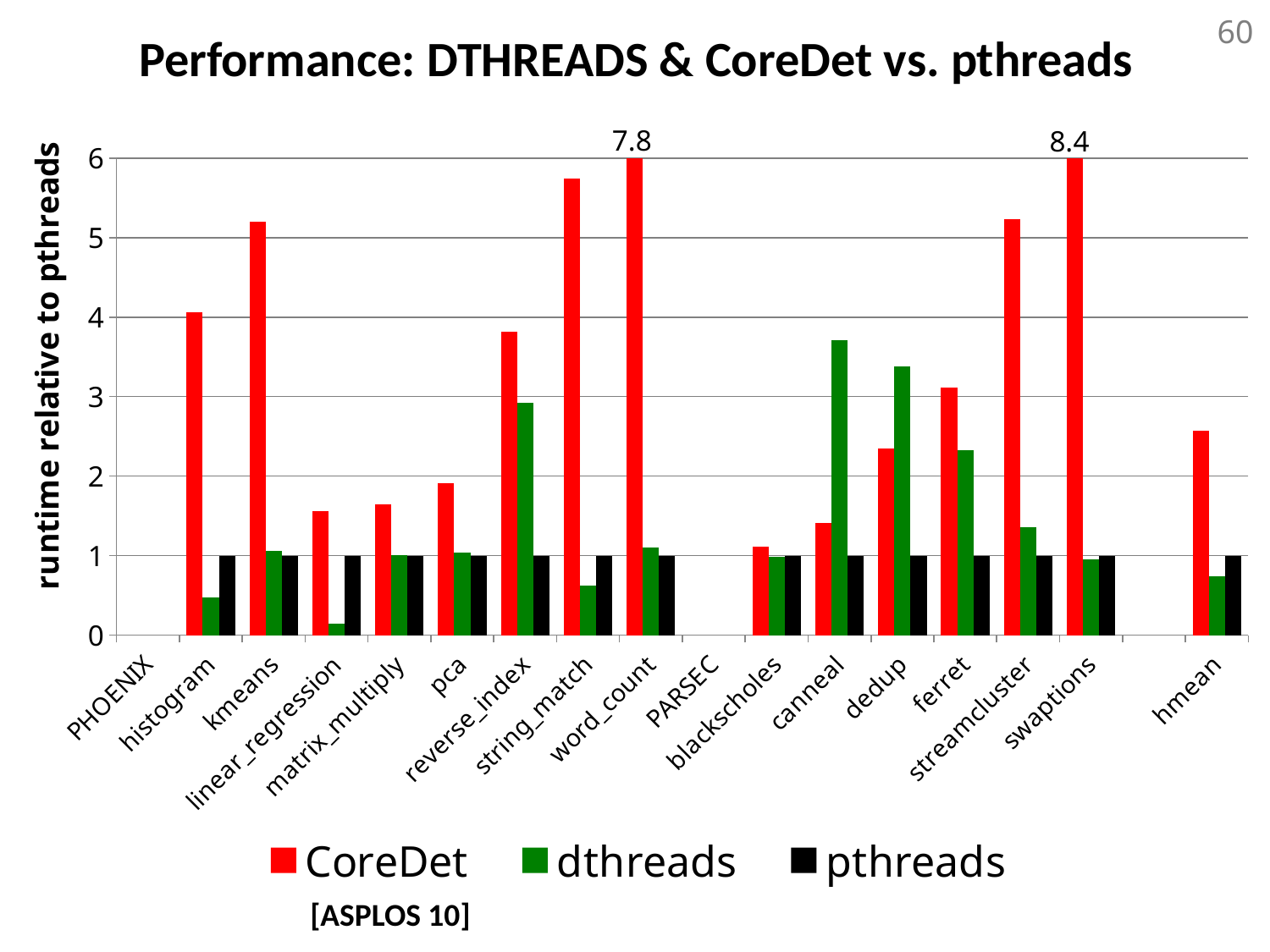
Which benchmark has the highest CoreDet value? swaptions Is the dthreads value for canneal greater or less than 3? greater For canneal, which is larger: the CoreDet value or the dthreads value? dthreads Is the dthreads value for linear_regression greater or less than 1? less What is the title of the y axis? runtime relative to pthreads What kind of chart is shown on the slide? bar chart What is the CoreDet value for swaptions? 8.4 What is the CoreDet value for word_count? 7.8 Is the CoreDet value for kmeans greater or less than 5? greater How many series does the legend list? 3 What is the difference between the CoreDet values for swaptions and word_count? 0.6 For histogram, which is larger: the CoreDet value or the dthreads value? CoreDet